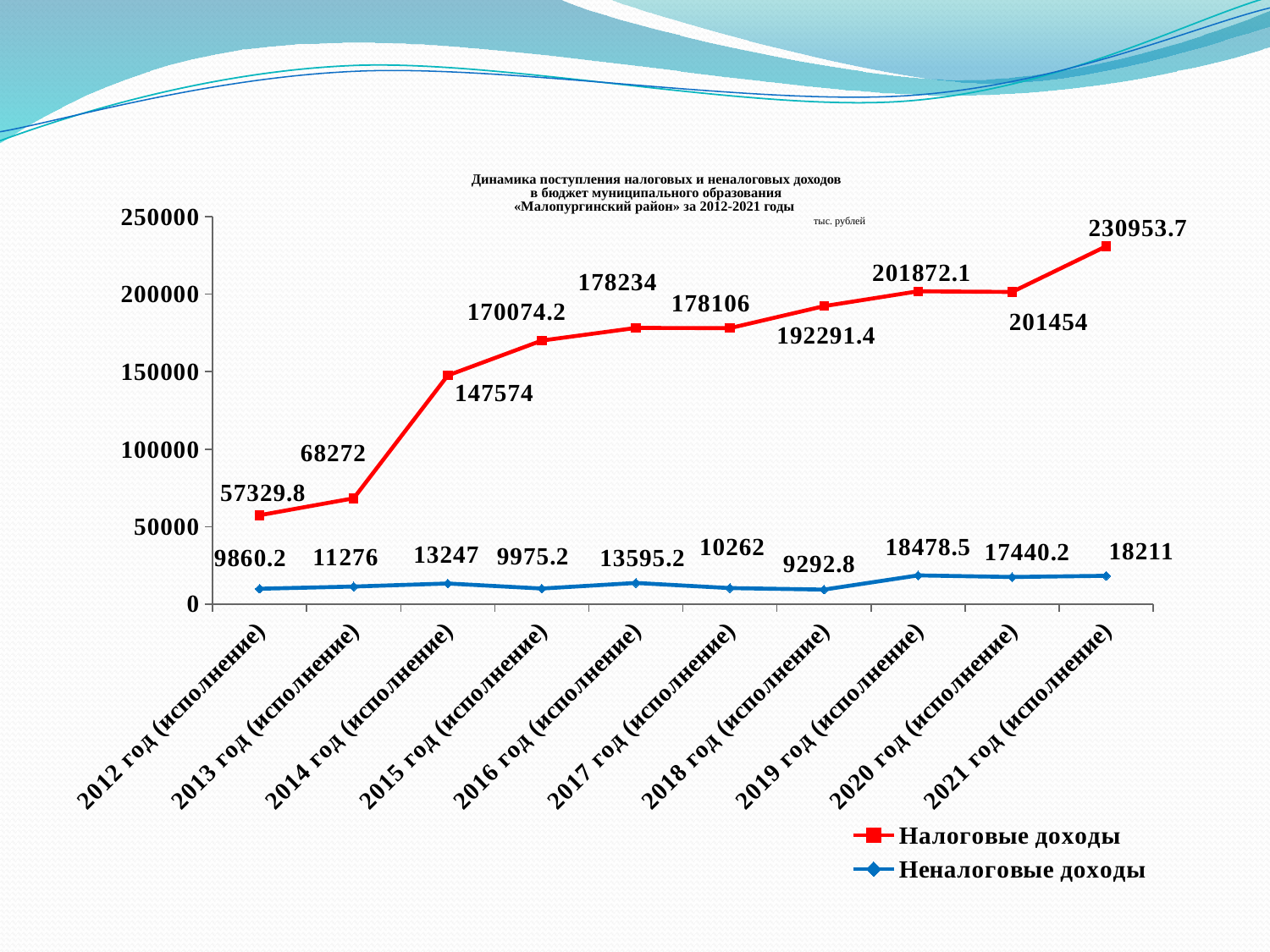
In which year is Налоговые доходы the highest? 2021 год (исполнение) In which year is Неналоговые доходы the lowest? 2018 год (исполнение) Does Налоговые доходы generally rise or fall from 2012 to 2021? rise Which is larger: Неналоговые доходы in 2016 or in 2017? 2016 How many years (categories) are plotted on the x axis? 10 What is the difference between Налоговые доходы in 2013 and 2012? 10942.2 What is the value of Налоговые доходы for 2014 год (исполнение)? 147574 How many series does the legend list? 2 What is the value of Неналоговые доходы for 2019 год (исполнение)? 18478.5 What type of chart is shown on the slide? line chart Which series is drawn in red? Налоговые доходы What is the value of Налоговые доходы for 2021 год (исполнение)? 230953.7